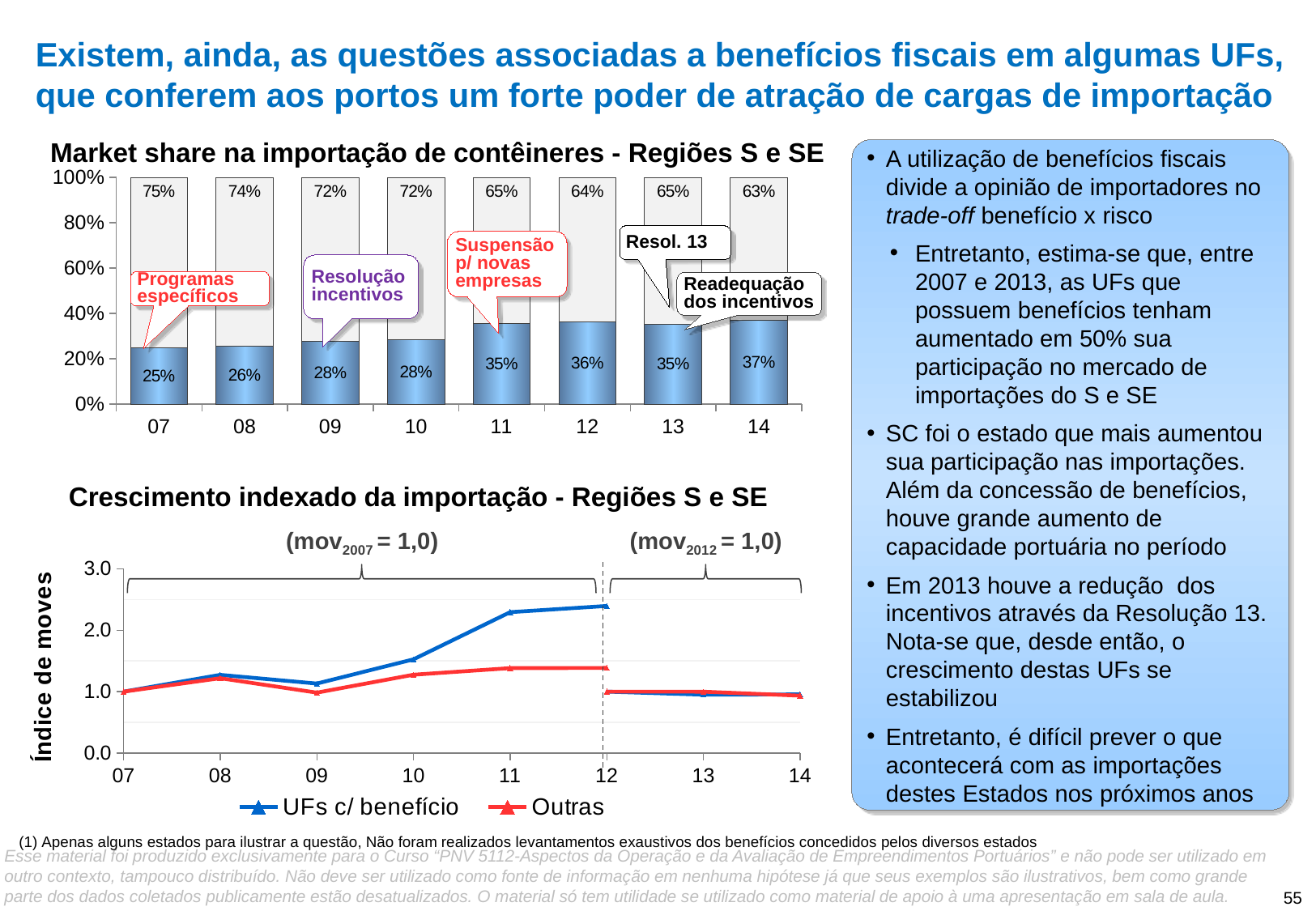
In the chart 'Crescimento indexado da importação - Regiões S e SE', is the value for 'UFs c/ benefício' at 12 greater or less than 2.0? greater In the chart 'Market share na importação de contêineres - Regiões S e SE', which year has the highest value for the lower (blue) segment? 14 In the chart 'Market share na importação de contêineres - Regiões S e SE', how many years are shown on the x axis? 8 In the chart 'Market share na importação de contêineres - Regiões S e SE', does the lower (blue) segment generally rise or fall from 07 to 14? rise In the chart 'Market share na importação de contêineres - Regiões S e SE', what is the value of the upper (grey) segment for 14? 63% In the chart 'Market share na importação de contêineres - Regiões S e SE', what is the difference between the lower (blue) segment values for 14 and 07? 12% In the chart 'Crescimento indexado da importação - Regiões S e SE', how many series does the legend list? 2 In the chart 'Market share na importação de contêineres - Regiões S e SE', what is the value of the lower (blue) segment for 07? 25% In the chart 'Market share na importação de contêineres - Regiões S e SE', what is the value of the lower (blue) segment for 11? 35% In the chart 'Market share na importação de contêineres - Regiões S e SE', which year has the lowest value for the lower (blue) segment? 07 In the chart 'Crescimento indexado da importação - Regiões S e SE', which series has the larger value at 11, 'UFs c/ benefício' or 'Outras'? UFs c/ benefício In the chart 'Market share na importação de contêineres - Regiões S e SE', what is the total of the stacked bar for 12? 100%